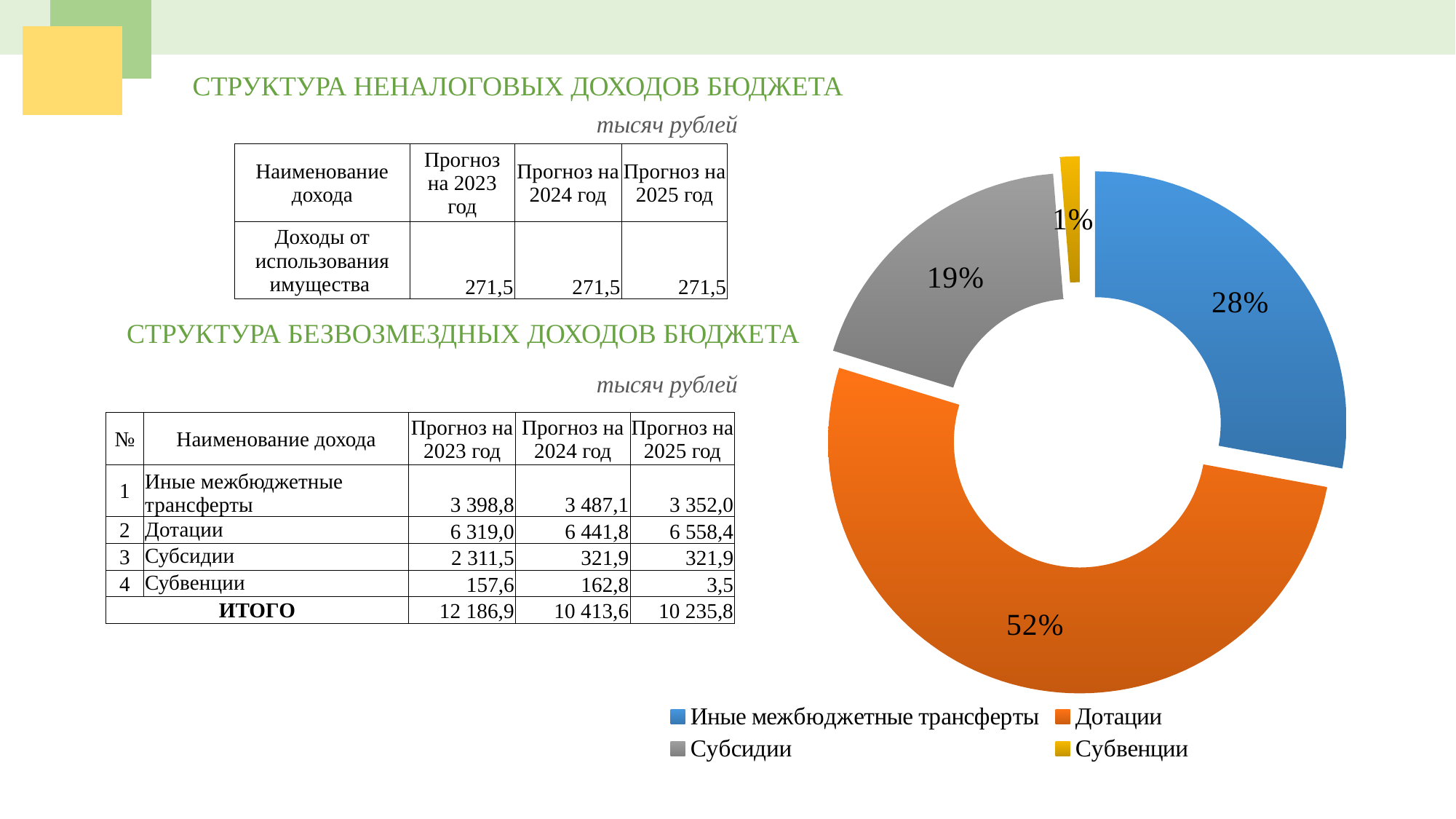
What colour is the Дотации slice in the doughnut chart? Orange What share of the doughnut chart does Субсидии represent? 19% How many entries does the legend of the doughnut chart list? 4 Which category has the smallest slice in the doughnut chart? Субвенции Which category has the largest slice in the doughnut chart? Дотации How many slices does the doughnut chart have? 4 In the doughnut chart, which slice is larger: Субсидии or Иные межбюджетные трансферты? Иные межбюджетные трансферты What share of the doughnut chart does Субвенции represent? 1% What type of chart is shown on the right side of the slide? Doughnut chart What share of the doughnut chart does Иные межбюджетные трансферты represent? 28% In the doughnut chart, how many percentage points larger is the Дотации slice than the Иные межбюджетные трансферты slice? 24 What share of the doughnut chart does Дотации represent? 52%